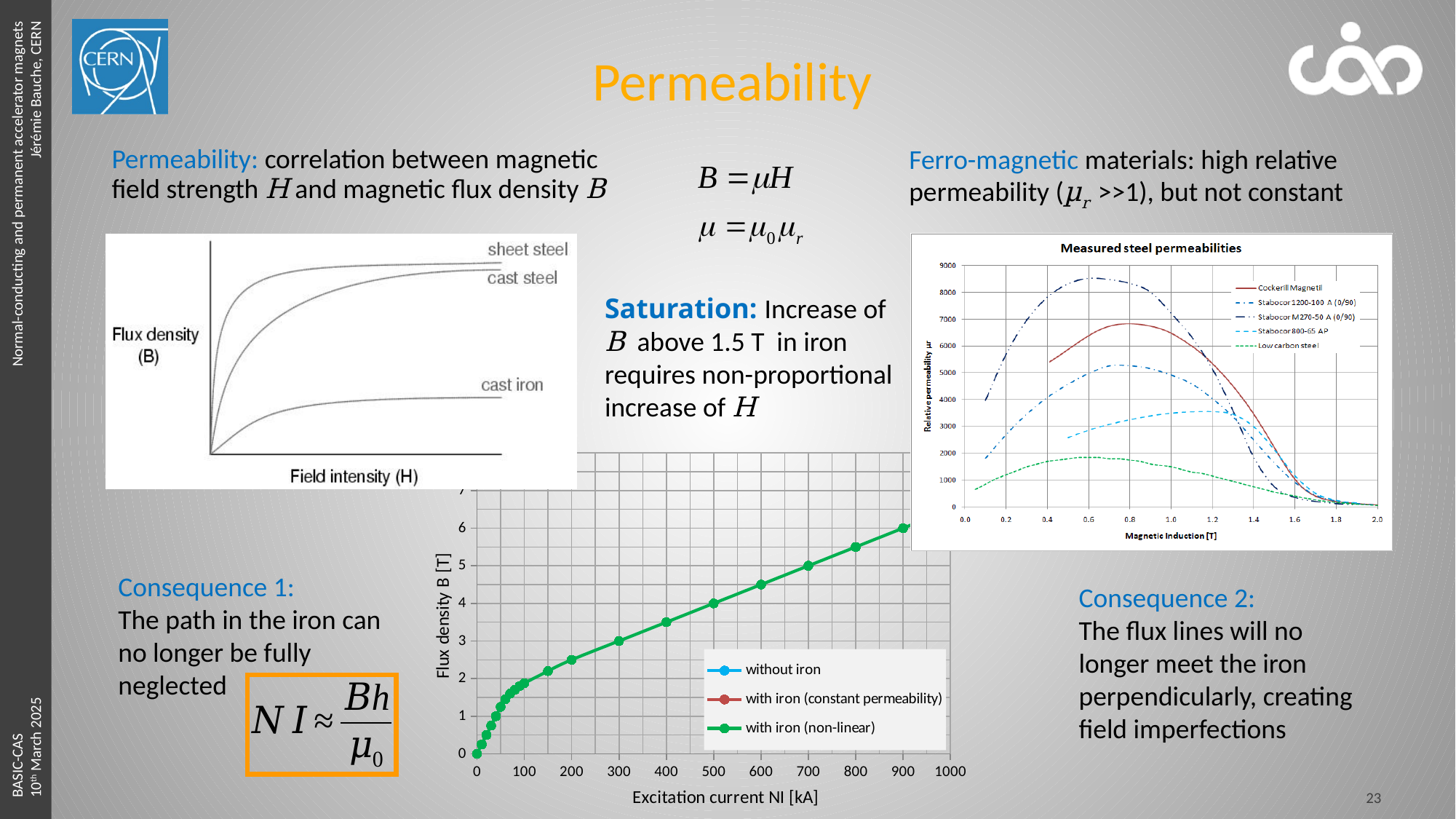
In the bottom chart of flux density versus excitation current, what is the flux density B at an excitation current of 700 kA? 5 T In the 'Measured steel permeabilities' chart, which material has the lowest relative permeability across the range? Low carbon steel In the 'Measured steel permeabilities' chart, is the peak relative permeability of Low carbon steel greater or less than 2000? less In the top-left chart of flux density versus field intensity, which material curve reaches the highest flux density? sheet steel In the bottom chart of flux density versus excitation current, what is the flux density B at an excitation current of 900 kA? 6 T In the 'Measured steel permeabilities' chart, which material reaches the highest relative permeability? Stabocor M270-50 A (0/90) In the bottom chart of flux density versus excitation current, what is the label of the x axis? Excitation current NI [kA] In the bottom chart of flux density versus excitation current, does the flux density rise or fall as the excitation current increases? rise In the bottom chart of flux density versus excitation current, what is the flux density B at an excitation current of 300 kA? 3 T In the 'Measured steel permeabilities' chart, how many series does the legend list? 5 In the bottom chart of flux density versus excitation current, how many series does the legend list? 3 In the bottom chart of flux density versus excitation current, what kind of chart is it? line chart